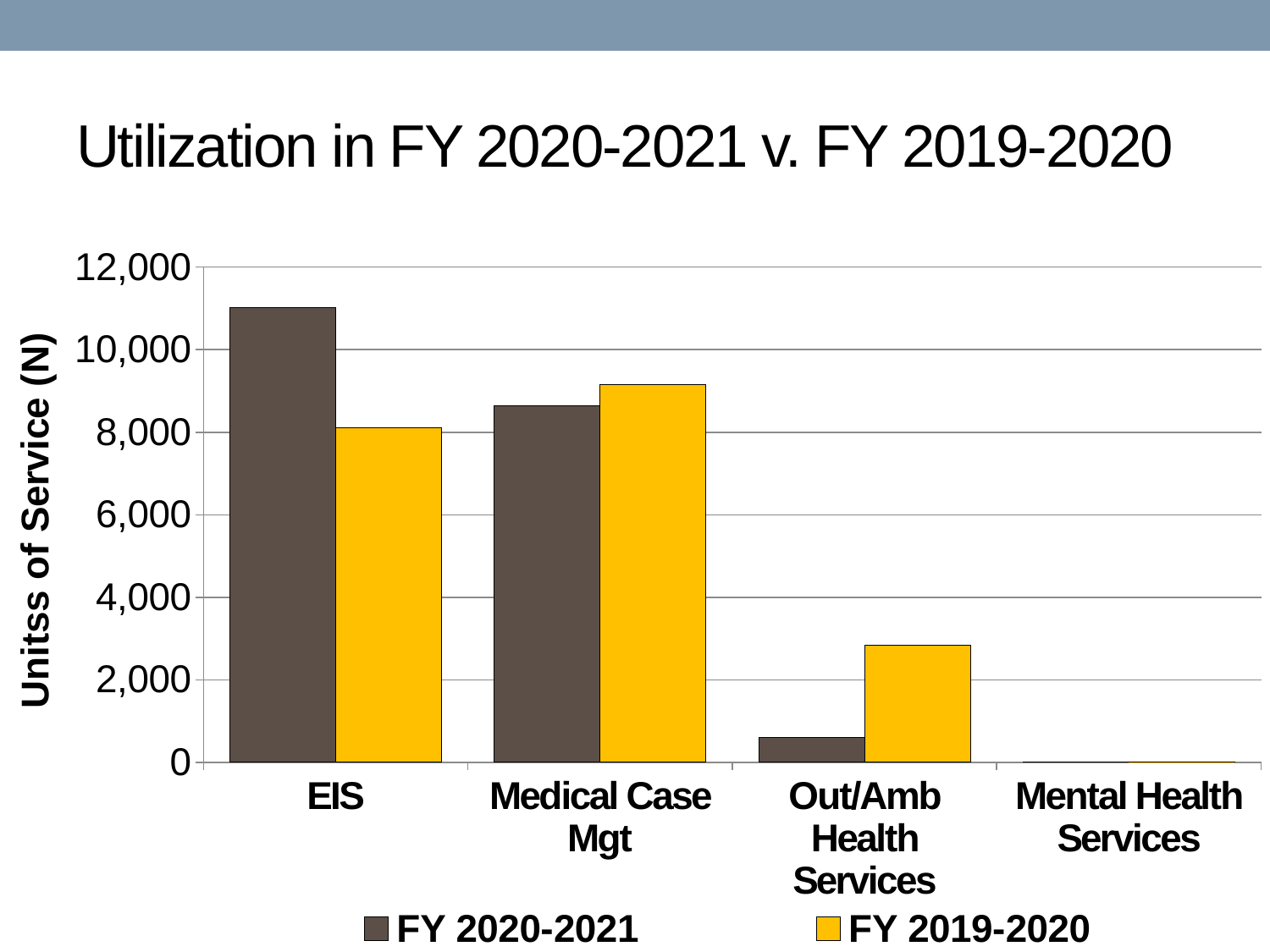
For EIS, which series is larger: FY 2020-2021 or FY 2019-2020? FY 2020-2021 For Out/Amb Health Services, which series is larger: FY 2020-2021 or FY 2019-2020? FY 2019-2020 How many series does the chart's legend list? 2 Which category has the highest FY 2020-2021 value? EIS Is the FY 2019-2020 value for Out/Amb Health Services greater or less than 2,000? greater Which category has the highest FY 2019-2020 value? Medical Case Mgt How many categories are shown on the x axis of the chart? 4 For Medical Case Mgt, which series is larger: FY 2020-2021 or FY 2019-2020? FY 2019-2020 Is the FY 2020-2021 value for EIS greater or less than 10,000? greater What is the title of the chart's vertical axis? Unitss of Service (N) What kind of chart is shown on the slide? bar chart Which category has the lowest values for both fiscal years? Mental Health Services